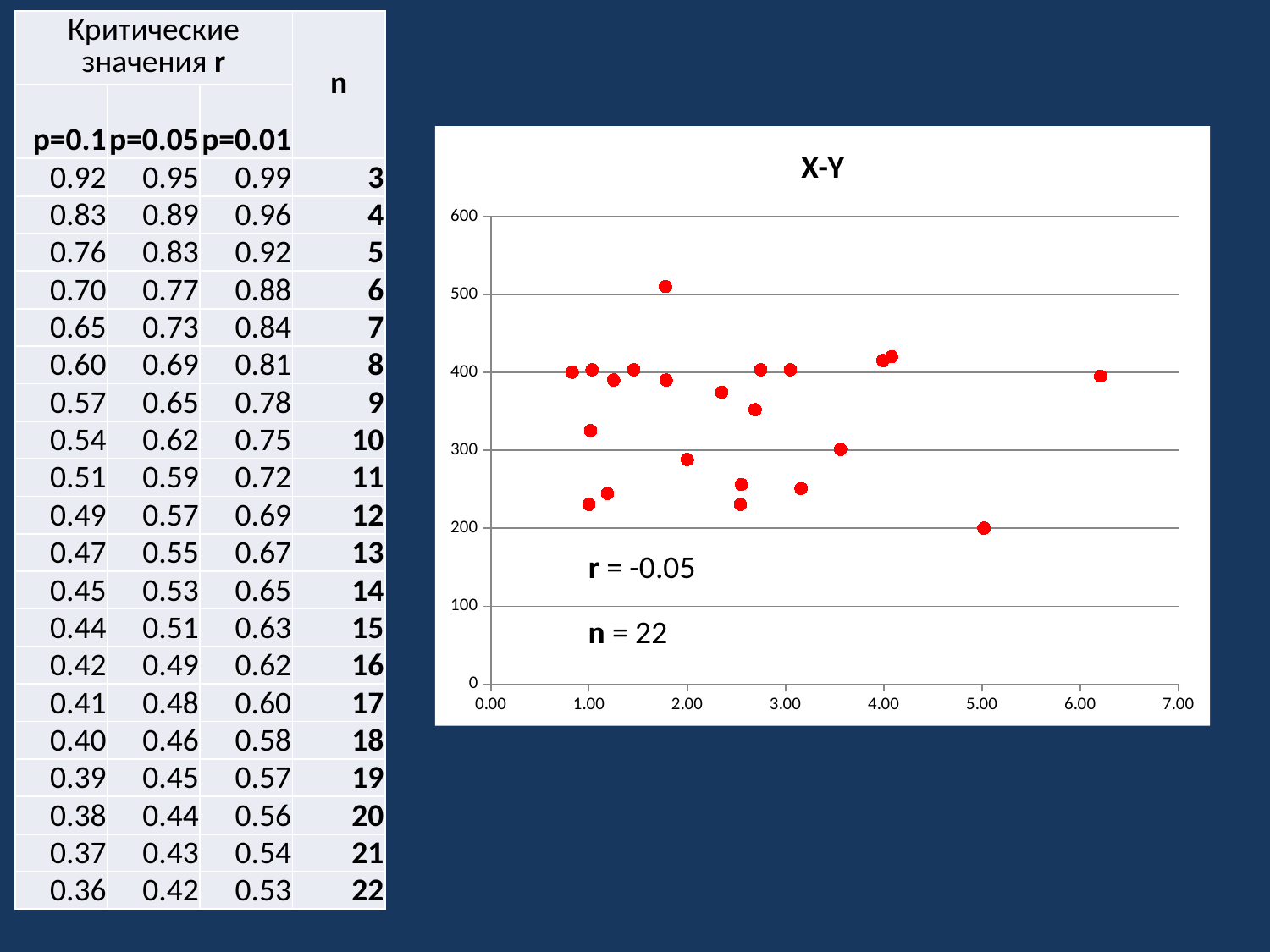
Which has the larger y value in the X-Y chart: the point near x = 5.00 or the point near x = 6.00? the point near x = 6.00 What correlation coefficient r is printed on the X-Y chart? -0.05 How many data points are plotted in the X-Y chart? 22 Is the y value of the lowest point in the X-Y chart (near x = 5.00) greater or less than 300? less Is the y value of the highest point in the X-Y chart greater or less than 400? greater Is the x value of the rightmost point in the X-Y chart greater or less than 6.00? greater What is the title of the chart? X-Y What kind of chart is shown on the slide? scatter chart Which has the larger y value in the X-Y chart: the point near x = 3.50 or the point near x = 5.00? the point near x = 3.50 Do the y values in the X-Y chart show a clear rising or falling trend as x increases? no clear trend